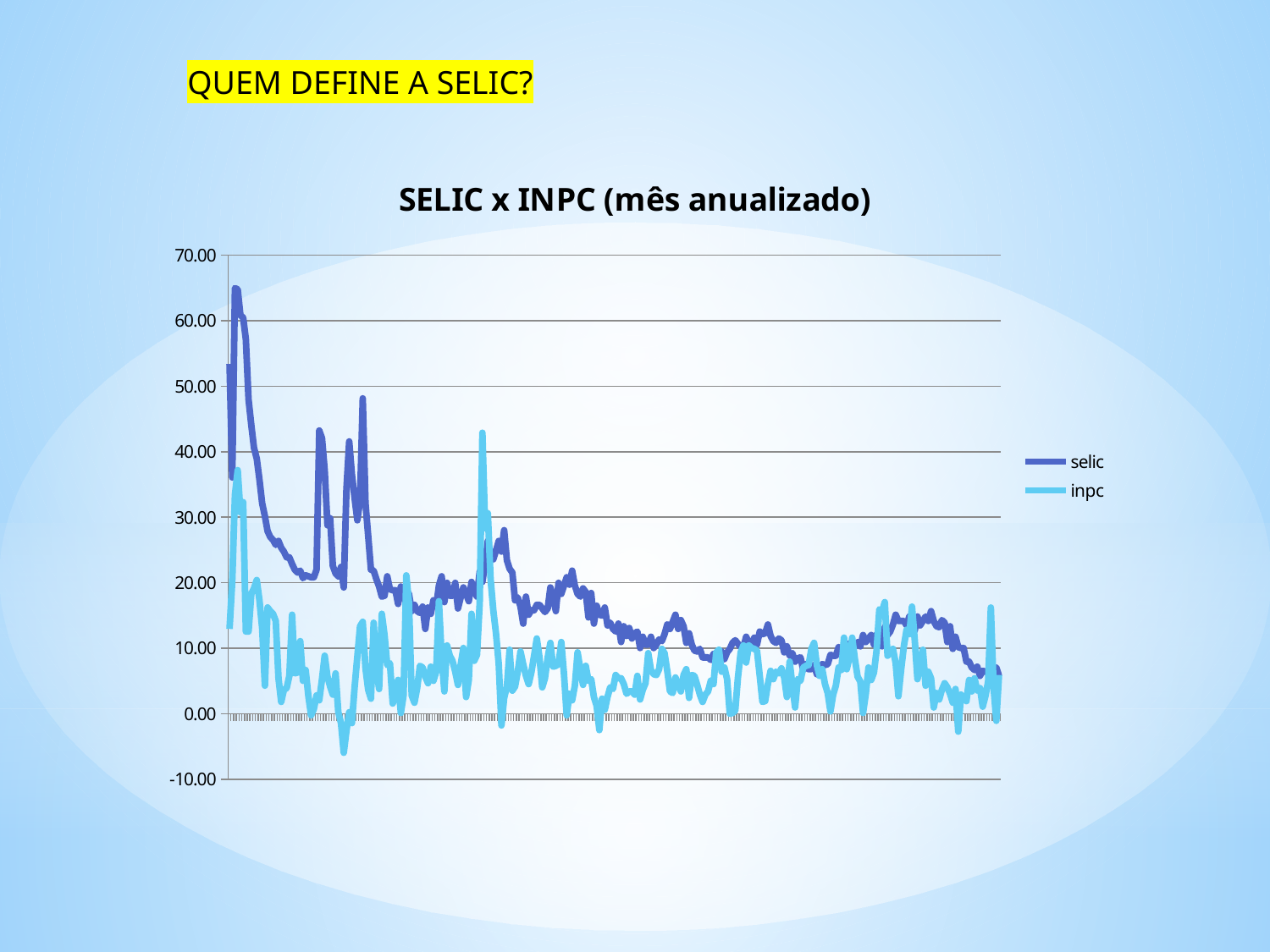
Is the highest value of the inpc series greater or less than 40.00? greater Is the lowest value of the inpc series greater or less than 0.00? less What is the title of the chart? SELIC x INPC (mês anualizado) Which series reaches the highest value on the chart? selic Which series has the higher peak value, selic or inpc? selic How many series does the chart's legend list? 2 Is the highest value of the selic series greater or less than 60.00? greater Overall, does the selic series rise or fall from the left of the chart to the right? fall Which series is drawn in the lighter blue colour? inpc Which series drops below 0.00 on the chart? inpc What kind of chart is shown on the slide? line chart